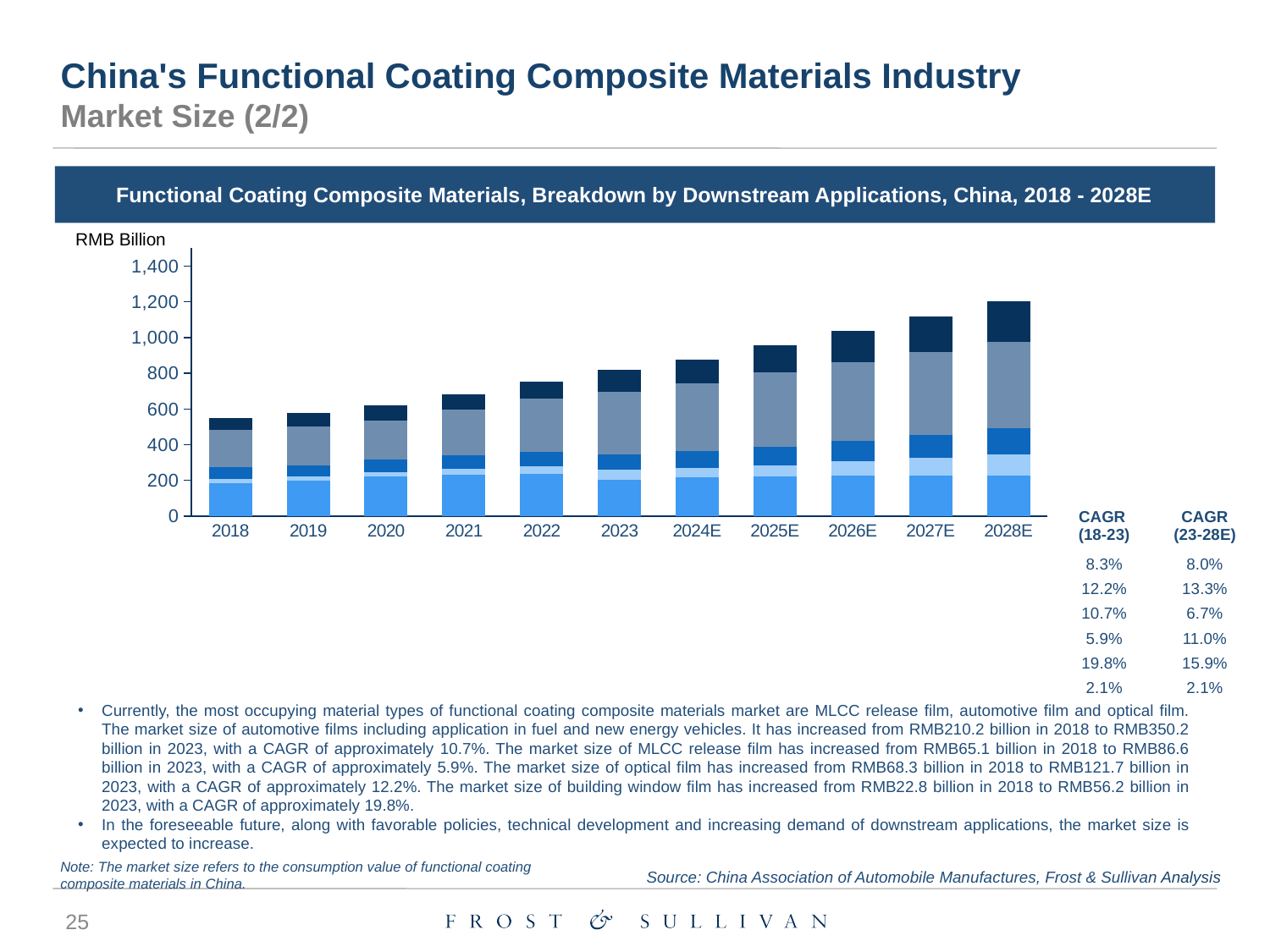
Do the total bar heights rise or fall from 2018 to 2028E? Rise Which year has the shortest total bar in the chart? 2018 What kind of chart is shown on the slide? Stacked bar chart How many years are shown on the x axis of the chart? 11 Is the total bar for 2021 greater or less than 600? greater Is the total bar for 2025E greater or less than 1,000? less What is the title of the chart? Functional Coating Composite Materials, Breakdown by Downstream Applications, China, 2018 - 2028E Is the total bar for 2027E greater or less than 1,000? greater Which year has the tallest total bar in the chart? 2028E What unit is the y axis of the chart measured in? RMB Billion Which total bar is larger, 2019 or 2026E? 2026E